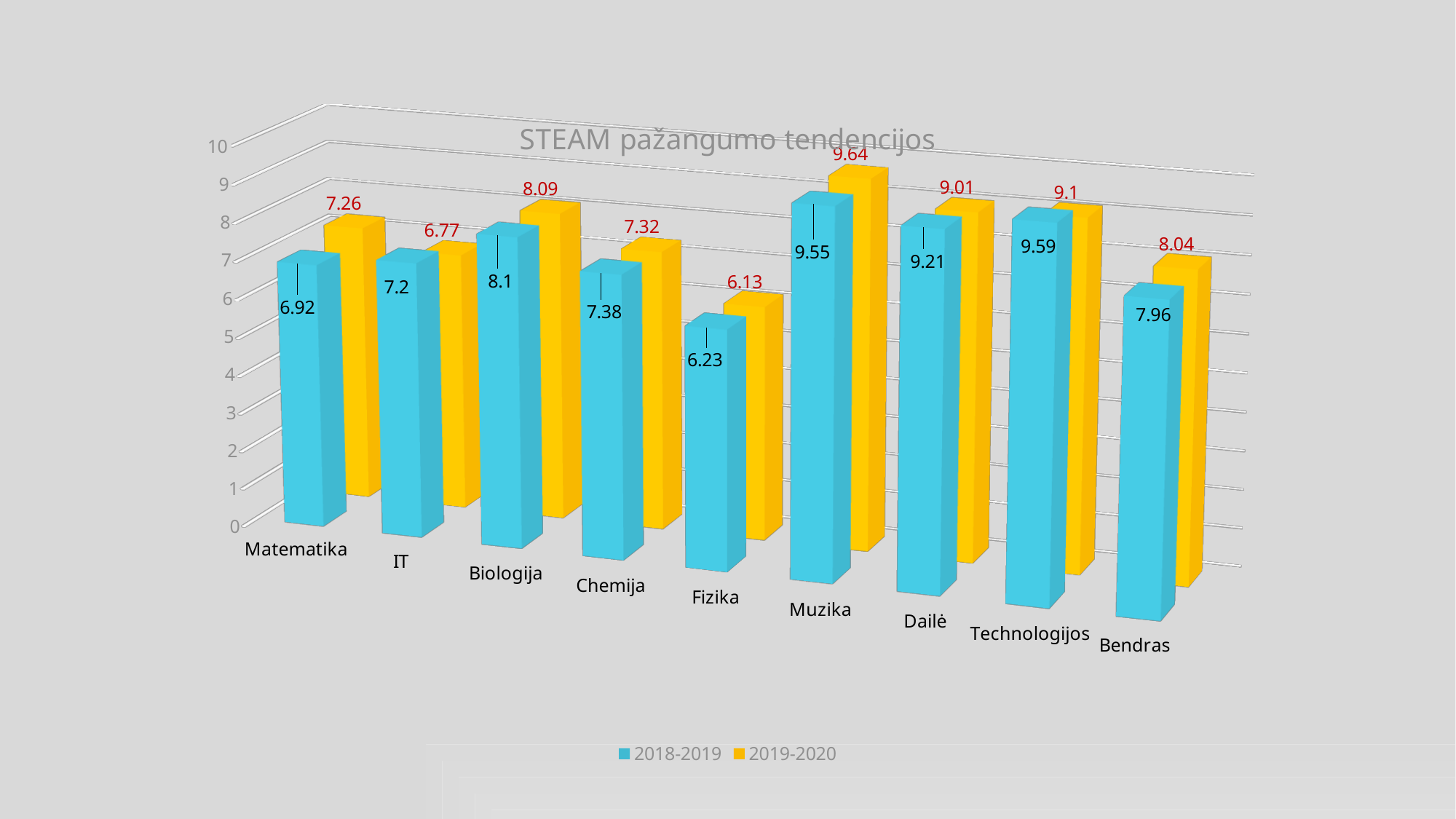
What kind of chart is shown on the slide? Bar chart Which category has the lowest value in the 2018-2019 series? Fizika For Technologijos, which series has the larger value, 2018-2019 or 2019-2020? 2018-2019 How many series does the legend list? 2 What is the value for Matematika in the 2018-2019 series? 6.92 What is the value for Fizika in the 2019-2020 series? 6.13 Which category has the highest value in the 2019-2020 series? Muzika How many categories are shown on the x axis? 9 What is the title of the chart? STEAM pažangumo tendencijos What is the value for Bendras in the 2019-2020 series? 8.04 For IT, which series has the larger value, 2018-2019 or 2019-2020? 2018-2019 What is the difference between the 2019-2020 and 2018-2019 values for Matematika? 0.34